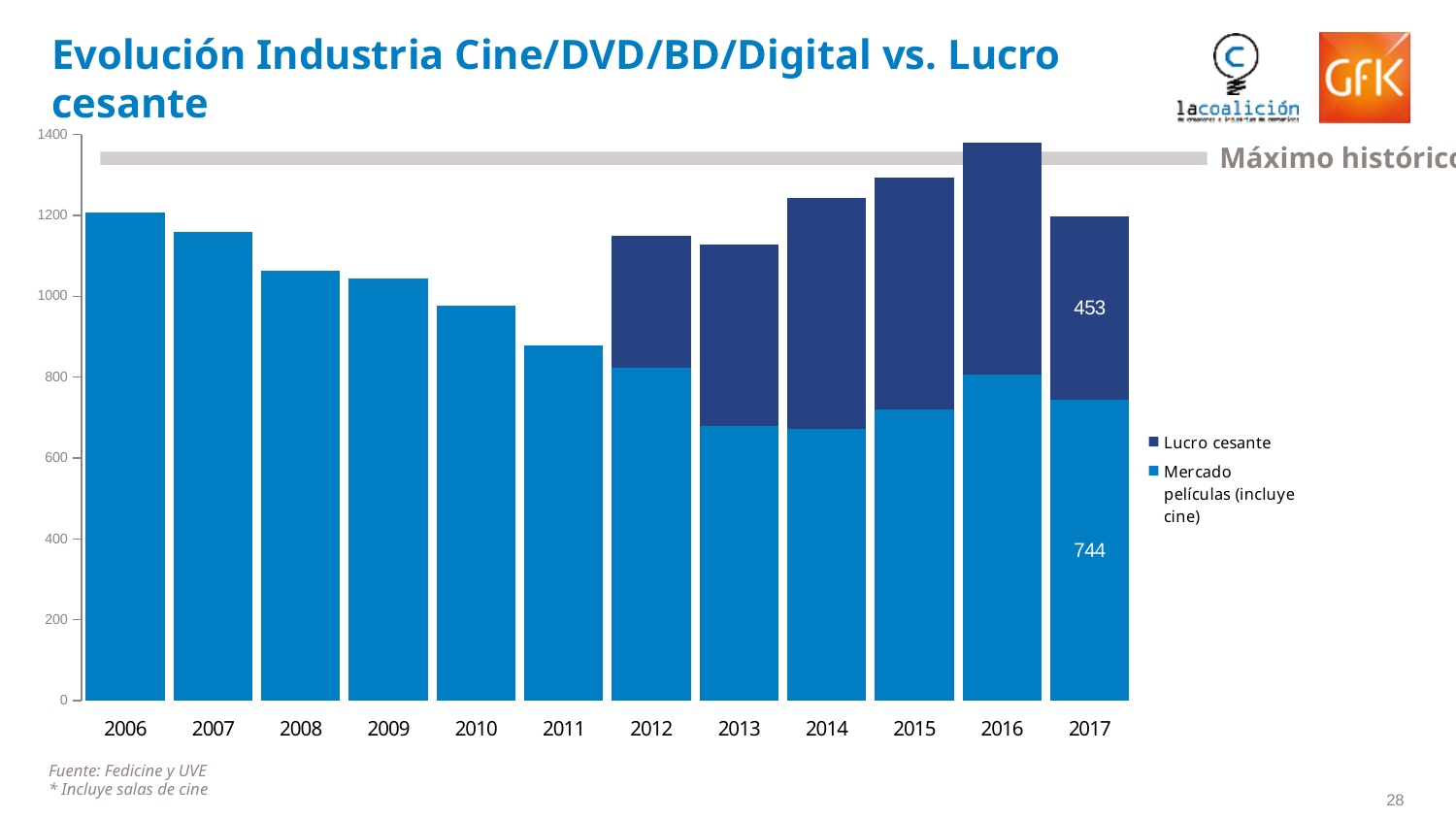
Which year has the tallest total bar? 2016 Does the Mercado películas series rise or fall from 2006 to 2011? fall What is the value of Lucro cesante for 2017? 453 Is the total bar for 2016 greater or less than 1200? greater How many years are shown on the x axis? 12 What kind of chart is shown on the slide? Stacked bar chart Is the value for Mercado películas in 2011 greater or less than 1000? less What is the value of Mercado películas (incluye cine) for 2017? 744 What label is given to the grey horizontal line near the top of the chart? Máximo histórico In 2017, which is larger: Lucro cesante or Mercado películas? Mercado películas What is the total of the stacked bar for 2017? 1197 How many series does the legend list? 2